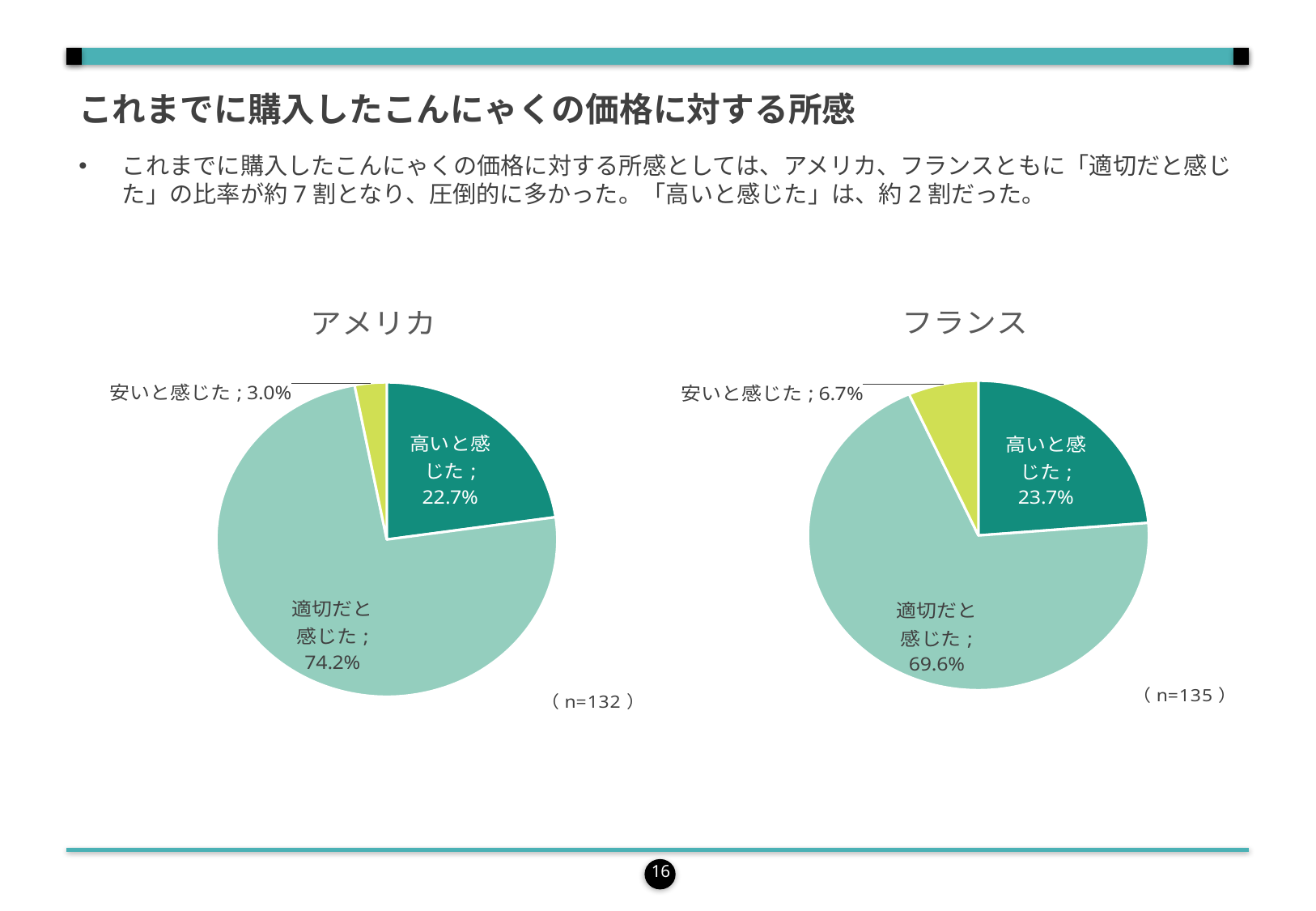
In the アメリカ chart, what share of respondents answered 適切だと感じた? 74.2% In the フランス chart, what share of respondents answered 適切だと感じた? 69.6% In the アメリカ chart, what share of respondents answered 安いと感じた? 3.0% Which is larger: the 安いと感じた share in the アメリカ chart or in the フランス chart? フランス In the アメリカ chart, which category has the largest slice? 適切だと感じた What is the sample size (n) shown for the フランス chart? n=135 What is the sample size (n) shown for the アメリカ chart? n=132 What is the difference between the 適切だと感じた share in the アメリカ chart and in the フランス chart? 4.6% How many categories does the フランス chart show? 3 In the フランス chart, what share of respondents answered 高いと感じた? 23.7% In the フランス chart, which category has the smallest slice? 安いと感じた What type of chart is the アメリカ chart? Pie chart